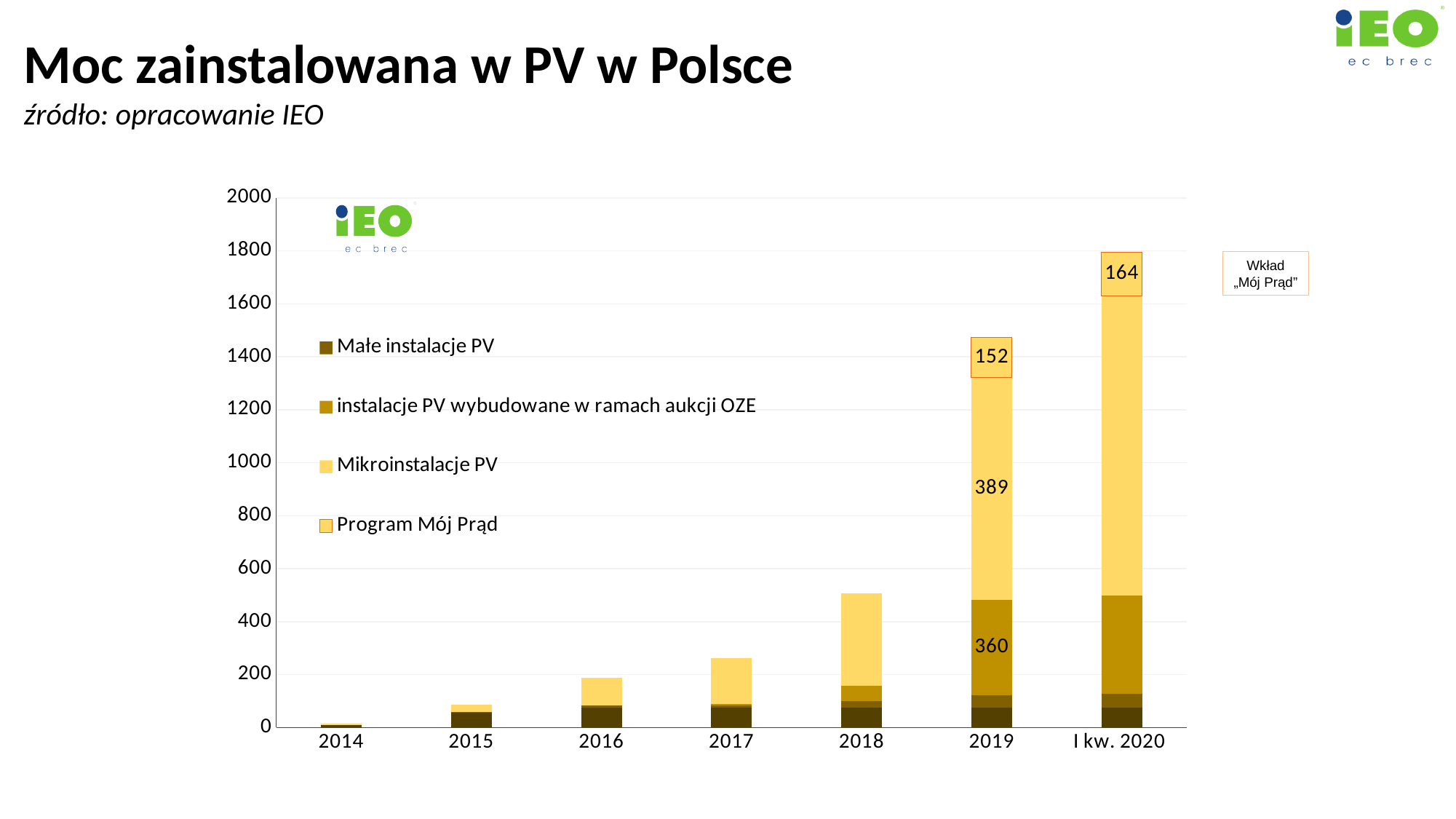
Is the total height of the 2018 bar greater or less than 400? greater What kind of chart is shown on the slide? bar chart What is the difference between Program Mój Prąd in I kw. 2020 and in 2019? 12 Which category has the tallest stacked bar? I kw. 2020 Which is larger: Program Mój Prąd in 2019 or in I kw. 2020? I kw. 2020 What is the value of Program Mój Prąd in 2019? 152 Do the total bar heights rise or fall from 2014 to I kw. 2020? rise What is the value of Program Mój Prąd in I kw. 2020? 164 How many series does the chart's legend list? 4 What is the value of instalacje PV wybudowane w ramach aukcji OZE in 2019? 360 How many categories are shown on the x axis of the chart? 7